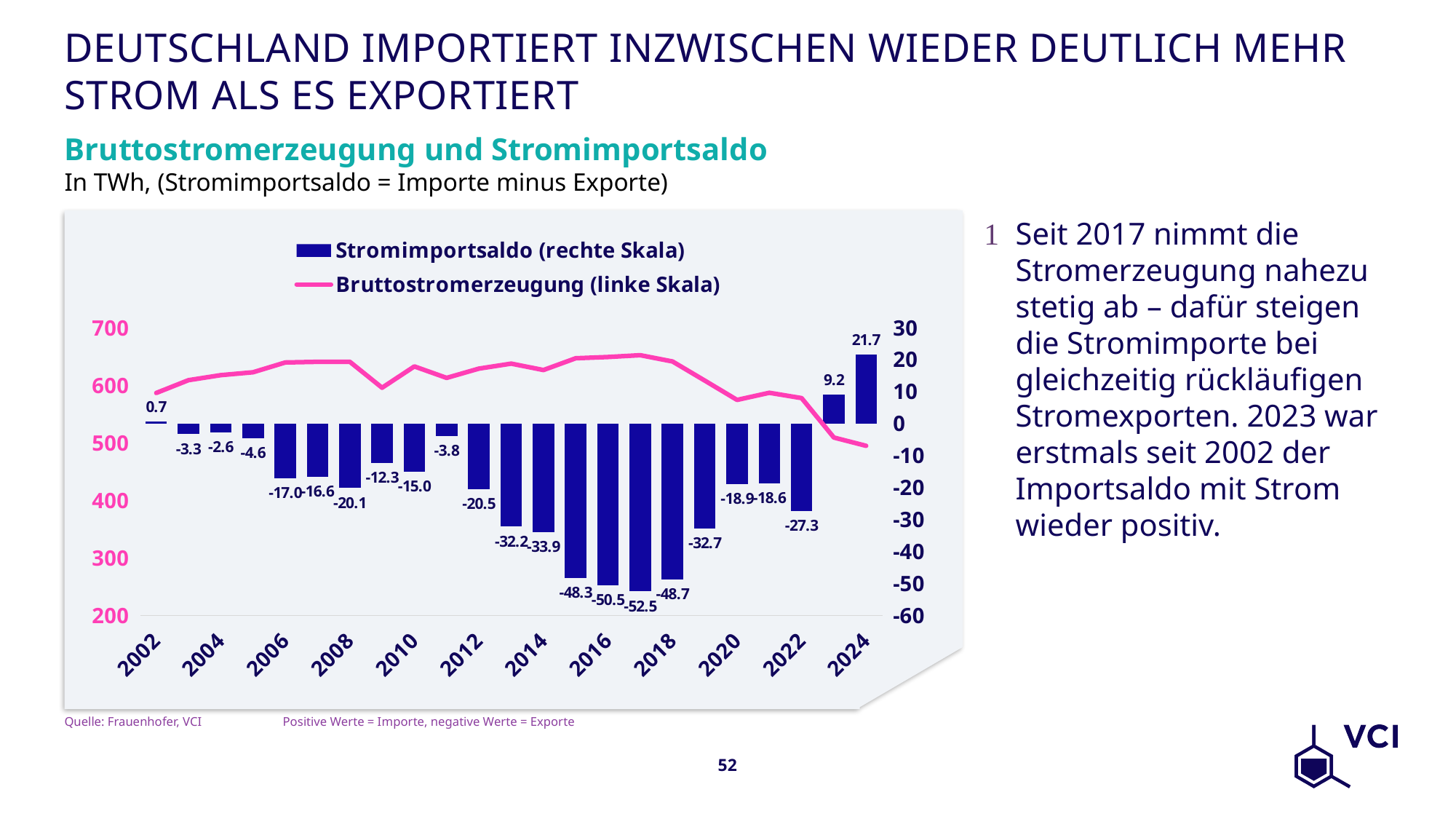
Is the Bruttostromerzeugung value for 2002 greater or less than 600? less In which year is the Stromimportsaldo bar lowest? 2017 Is the Bruttostromerzeugung value for 2017 greater or less than 600? greater What is the difference between the Stromimportsaldo values for 2024 and 2023? 12.5 In which year is the Stromimportsaldo bar highest? 2024 What is the Stromimportsaldo value for 2024? 21.7 What is the Stromimportsaldo value for 2002? 0.7 Does the Bruttostromerzeugung line rise or fall from 2017 to 2024? fall How many series does the legend list? 2 Which year has the larger Stromimportsaldo value, 2013 or 2019? 2013 What is the Stromimportsaldo value for 2017? -52.5